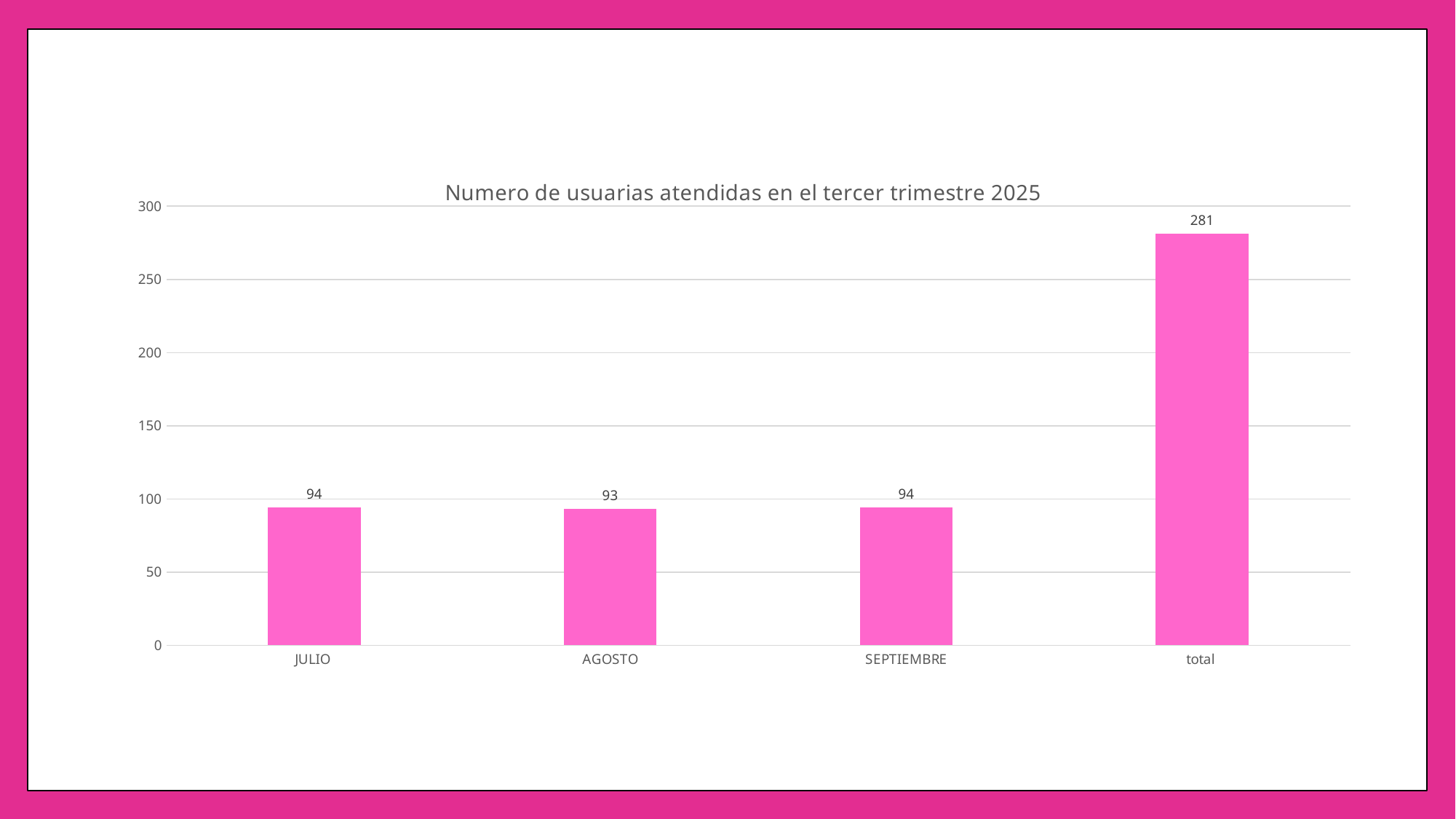
What is the value for total? 281 What is the difference between the value for total and the value for JULIO? 187 What is the value for JULIO? 94 What is the title of the chart? Numero de usuarias atendidas en el tercer trimestre 2025 Which category has the lowest value? AGOSTO What is the difference between the value for JULIO and the value for AGOSTO? 1 Which category has the highest value? total How many categories are shown on the x axis? 4 What is the value for AGOSTO? 93 What is the value for SEPTIEMBRE? 94 What kind of chart is shown on the slide? bar chart Which is larger, the value for total or the value for SEPTIEMBRE? total